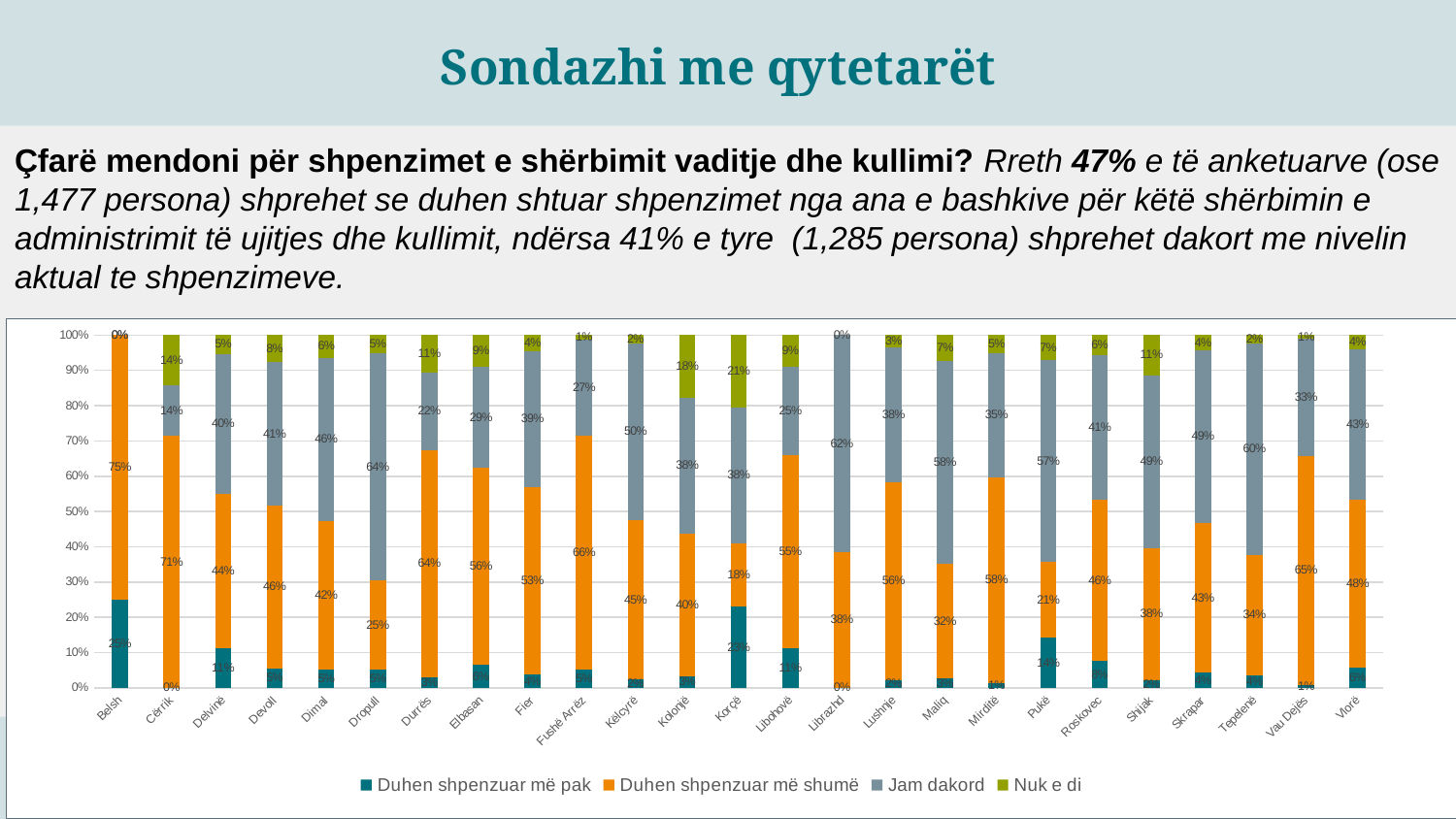
What is the difference between the "Duhen shpenzuar më shumë" values for Belsh and Cërrik? 4 percentage points What kind of chart is shown on the slide? Stacked bar chart Which series is shown in orange in the legend? Duhen shpenzuar më shumë What is the value of "Jam dakord" for Dropull? 64% How many municipalities (categories) are shown on the x axis? 25 What is the value of "Duhen shpenzuar më shumë" for Cërrik? 71% Which municipality has the highest value for "Duhen shpenzuar më shumë"? Belsh What is the value of "Nuk e di" for Korçë? 21% What is the value of "Duhen shpenzuar më shumë" for Belsh? 75% What is the value of "Jam dakord" for Librazhd? 62% How many series does the legend list? 4 Which is larger, the "Duhen shpenzuar më shumë" value for Durrës or for Dropull? Durrës